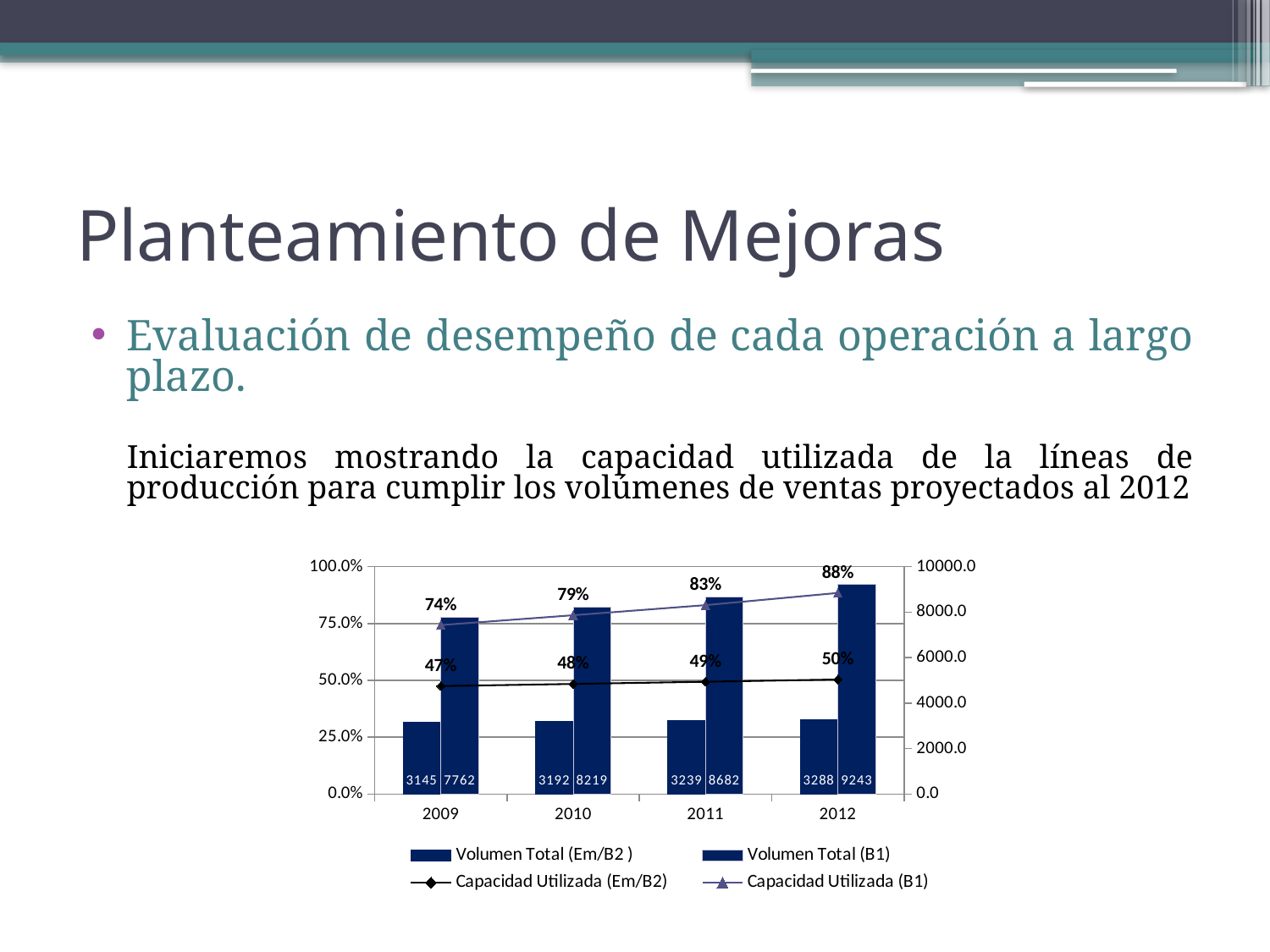
What is the Capacidad Utilizada (B1) in 2011? 83% Does Capacidad Utilizada (B1) rise or fall from 2009 to 2012? rise How many series does the legend list? 4 In which year is Capacidad Utilizada (B1) lowest? 2009 Which is larger in 2010: Volumen Total (B1) or Volumen Total (Em/B2)? Volumen Total (B1) In which year is Volumen Total (B1) highest? 2012 How many years are shown on the x axis? 4 What kind of chart is shown on the slide? Combined bar and line chart What is the value of Volumen Total (B1) in 2012? 9243 What is the Capacidad Utilizada (Em/B2) in 2010? 48% What is the difference between Volumen Total (B1) and Volumen Total (Em/B2) in 2011? 5443 What is the value of Volumen Total (Em/B2) in 2009? 3145